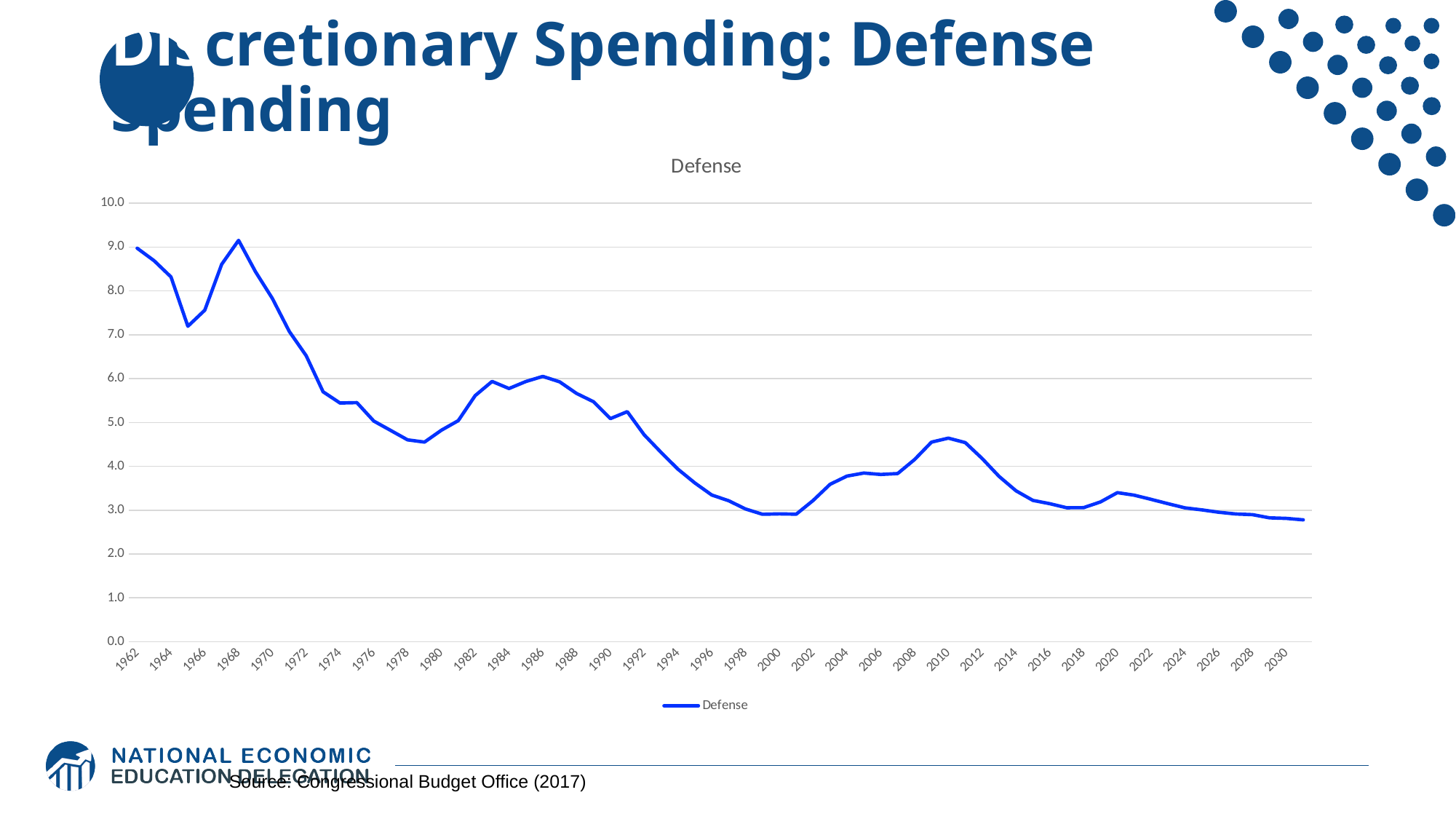
Is the value for 1978 greater or less than 5.0? less What kind of chart is shown on the slide? line chart In which year does the Defense line reach its highest value? 1968 Which year has the higher value, 1962 or 2030? 1962 Is the value for 1968 greater or less than 8.0? greater How many series does the legend list? 1 What is the first year shown on the x axis? 1962 Overall, does the Defense line rise or fall from 1962 to 2030? fall Is the value for 2010 greater or less than 4.0? greater What is the title of the chart? Defense